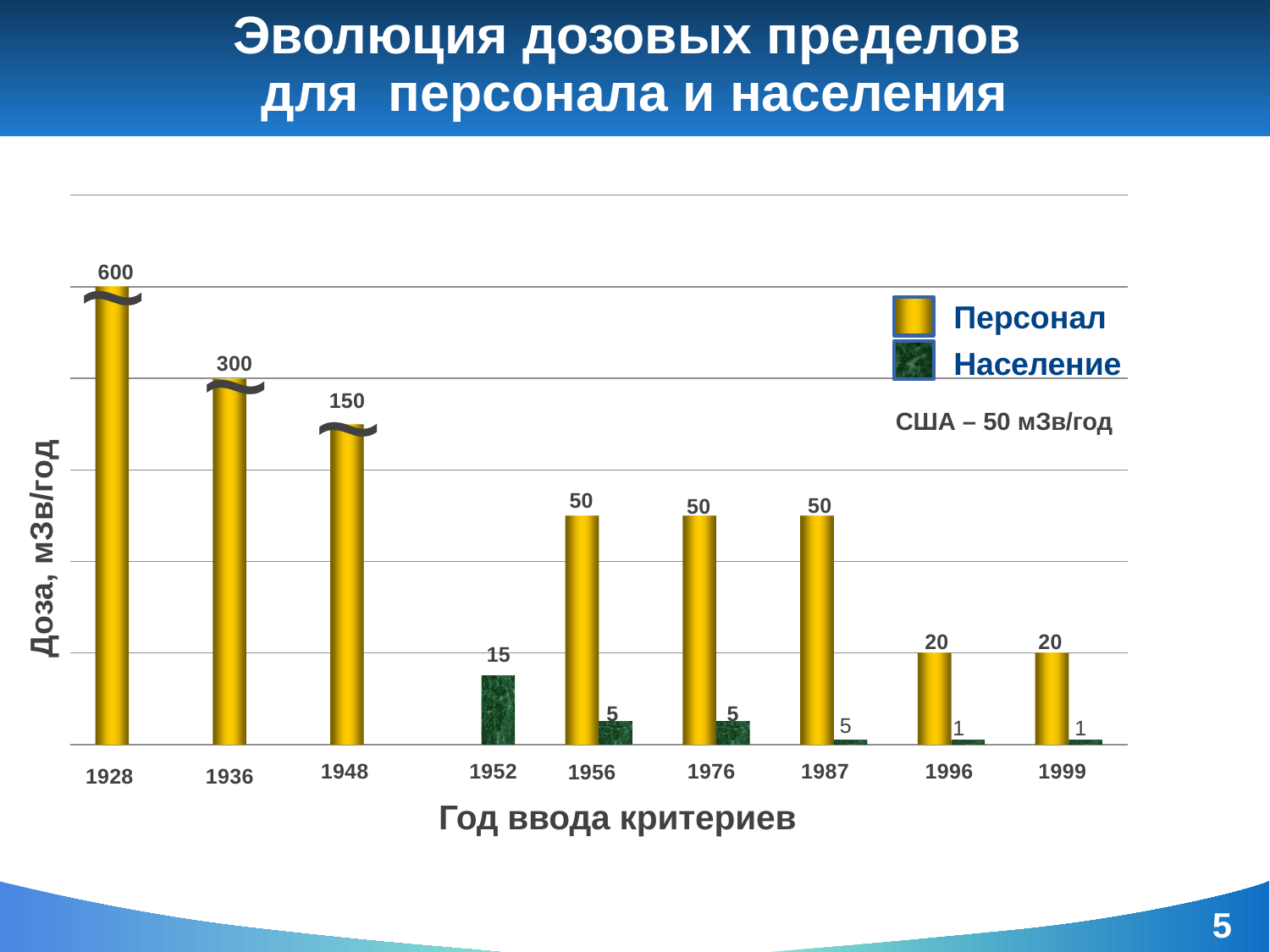
What kind of chart is shown on the slide? bar chart What is the difference between the Персонал values for 1928 and 1936? 300 What is the value for Персонал in 1948? 150 How many series does the legend list? 2 Which year has the highest value for Население? 1952 Which is larger: the Персонал value in 1948 or the Персонал value in 1956? 1948 Which year has the highest value for Персонал? 1928 What is the value for Персонал in 1928? 600 What is the value for Население in 1952? 15 What is the value for Население in 1999? 1 How many years are shown on the x axis? 9 What is the difference between the Персонал and Население values in 1987? 45